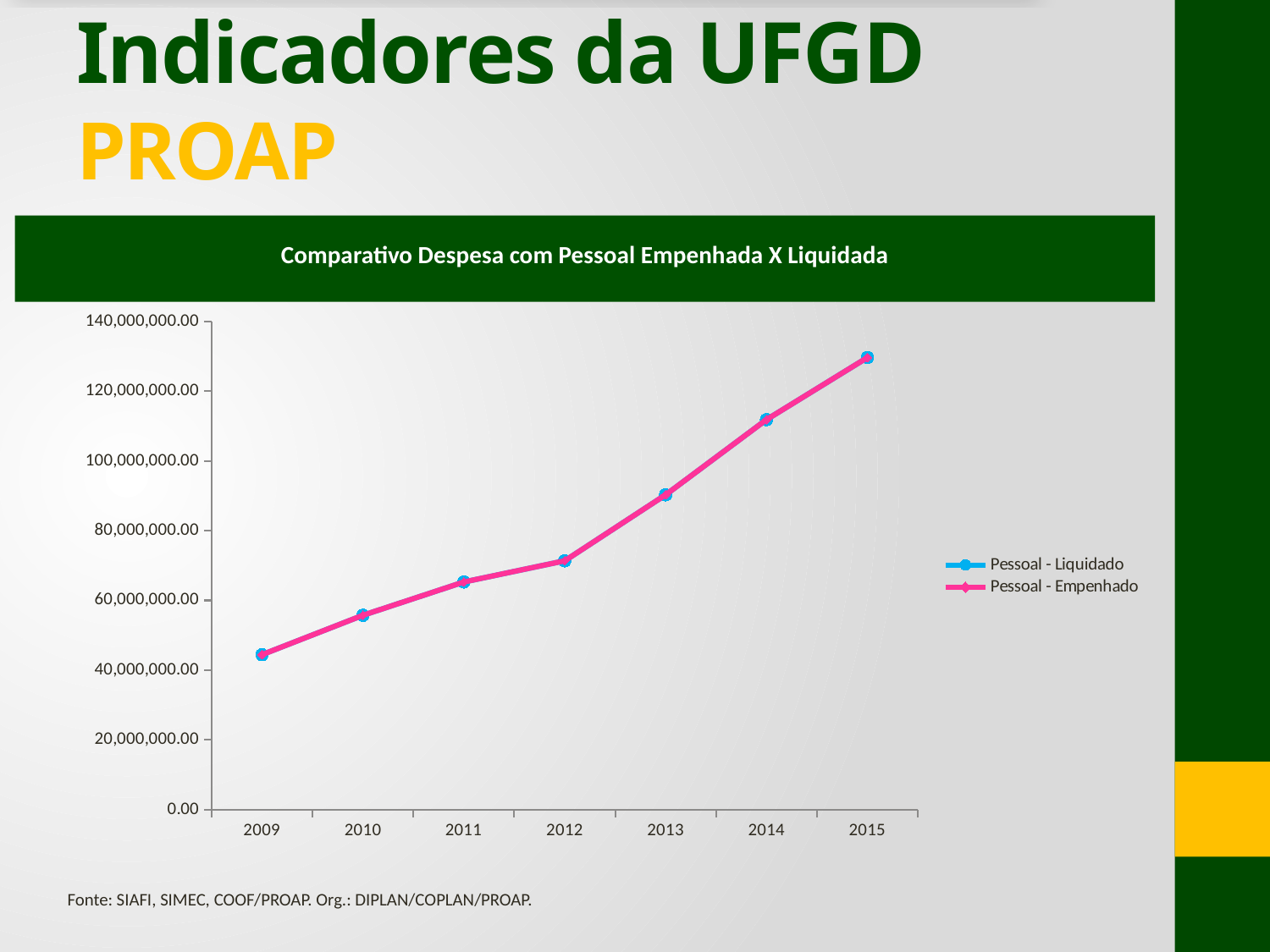
Which year has the highest value for Pessoal - Empenhado? 2015 Is the value for Pessoal - Liquidado in 2013 greater or less than 80,000,000.00? greater What is the title of the chart? Comparativo Despesa com Pessoal Empenhada X Liquidada Do the values for Pessoal - Empenhado rise or fall from 2009 to 2015? Rise Is the value for Pessoal - Empenhado in 2009 greater or less than 60,000,000.00? less Is the value for Pessoal - Empenhado in 2014 greater or less than 120,000,000.00? less Which year has the lowest value for Pessoal - Liquidado? 2009 What kind of chart is shown on the slide? Line chart How many series does the legend list? 2 How many years are plotted along the x axis? 7 Which is larger for Pessoal - Liquidado: the value in 2012 or the value in 2014? 2014